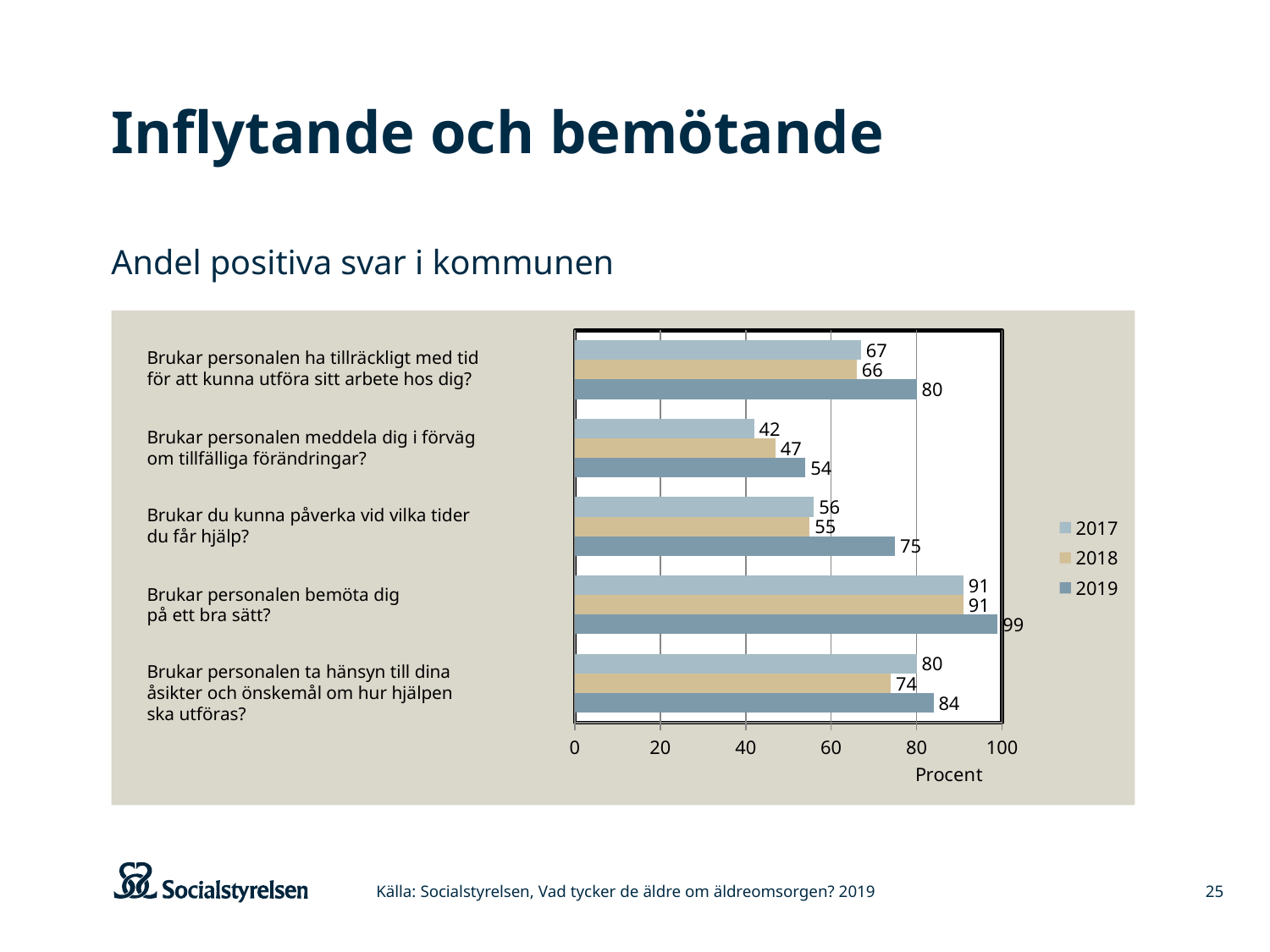
For "Brukar personalen ta hänsyn till dina åsikter och önskemål om hur hjälpen ska utföras?", which year has the larger value, 2017 or 2018? 2017 Is the 2019 value for "Brukar personalen meddela dig i förväg om tillfälliga förändringar?" greater or less than 60? less What kind of chart is shown on the slide? Bar chart What is the 2019 value for "Brukar personalen ha tillräckligt med tid för att kunna utföra sitt arbete hos dig?"? 80 Which question has the lowest 2017 value? Brukar personalen meddela dig i förväg om tillfälliga förändringar? What is the difference between the 2019 and 2018 values for "Brukar du kunna påverka vid vilka tider du får hjälp?"? 20 What is the label on the horizontal axis of the chart? Procent How many questions (categories) are shown in the chart? 5 What is the 2018 value for "Brukar personalen meddela dig i förväg om tillfälliga förändringar?"? 47 Which question has the highest 2019 value? Brukar personalen bemöta dig på ett bra sätt? How many series does the legend list? 3 What is the 2017 value for "Brukar du kunna påverka vid vilka tider du får hjälp?"? 56